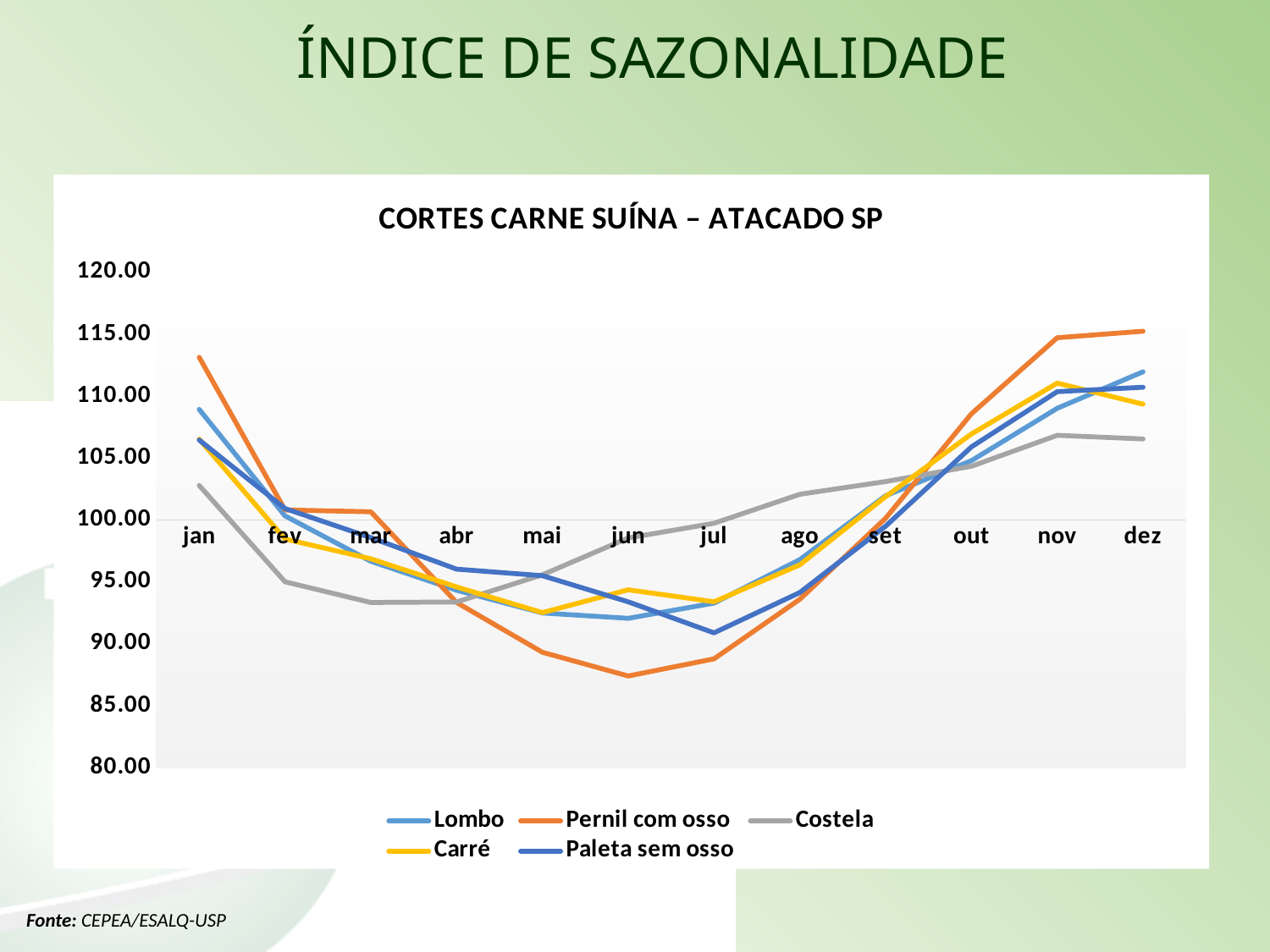
Is the value for Costela in mar greater or less than 95.00? less Does the Pernil com osso line rise or fall from jan to jun? fall Is the value for Pernil com osso in dez greater or less than 110.00? greater Which series has the highest value in jan? Pernil com osso Which series has the highest value in dez? Pernil com osso How many months are shown on the x axis? 12 Which series has the lowest value in jun? Pernil com osso In jun, which is higher: Costela or Pernil com osso? Costela What is the title of the chart? CORTES CARNE SUÍNA – ATACADO SP What kind of chart is shown on the slide? line chart How many series does the legend list? 5 Is the value for Pernil com osso in jun greater or less than 90.00? less